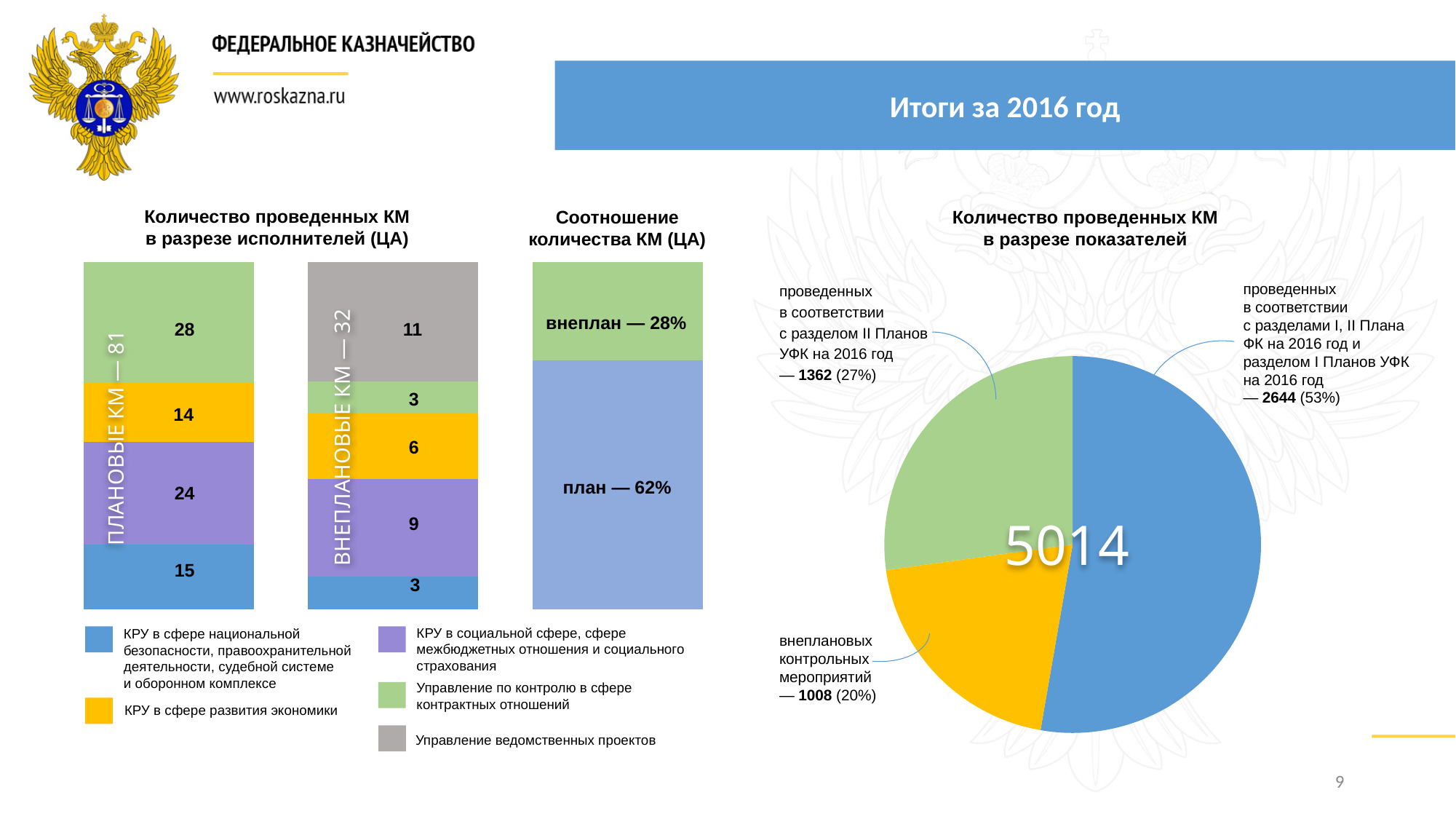
In the chart 'Количество проведенных КМ в разрезе исполнителей (ЦА)', what is the total of the 'ВНЕПЛАНОВЫЕ КМ' stacked bar? 32 In the chart 'Количество проведенных КМ в разрезе исполнителей (ЦА)', what is the value for 'Управление ведомственных проектов' in the 'ВНЕПЛАНОВЫЕ КМ' bar? 11 In the chart 'Количество проведенных КМ в разрезе исполнителей (ЦА)', which is larger in the 'ПЛАНОВЫЕ КМ' bar: the value for 'КРУ в социальной сфере, сфере межбюджетных отношения и социального страхования' or the value for 'КРУ в сфере национальной безопасности, правоохранительной деятельности, судебной системе и обороном комплексе'? КРУ в социальной сфере, сфере межбюджетных отношения и социального страхования In the chart 'Количество проведенных КМ в разрезе исполнителей (ЦА)', which segment is the largest in the 'ПЛАНОВЫЕ КМ' bar? Управление по контролю в сфере контрактных отношений In the chart 'Соотношение количества КМ (ЦА)', what share is shown for 'внеплан'? 28% In the chart 'Соотношение количества КМ (ЦА)', what share is shown for 'план'? 62% In the chart 'Количество проведенных КМ в разрезе исполнителей (ЦА)', what is the value for 'Управление по контролю в сфере контрактных отношений' in the 'ПЛАНОВЫЕ КМ' bar? 28 In the pie chart 'Количество проведенных КМ в разрезе показателей', what total number is shown in the centre of the pie? 5014 In the pie chart 'Количество проведенных КМ в разрезе показателей', what is the value for 'внеплановых контрольных мероприятий'? 1008 (20%) In the chart 'Количество проведенных КМ в разрезе исполнителей (ЦА)', what is the total of the 'ПЛАНОВЫЕ КМ' stacked bar? 81 In the chart 'Количество проведенных КМ в разрезе исполнителей (ЦА)', what is the difference between the 'КРУ в сфере развития экономики' values in the 'ПЛАНОВЫЕ КМ' and 'ВНЕПЛАНОВЫЕ КМ' bars? 8 What kind of chart is 'Количество проведенных КМ в разрезе показателей'? Pie chart